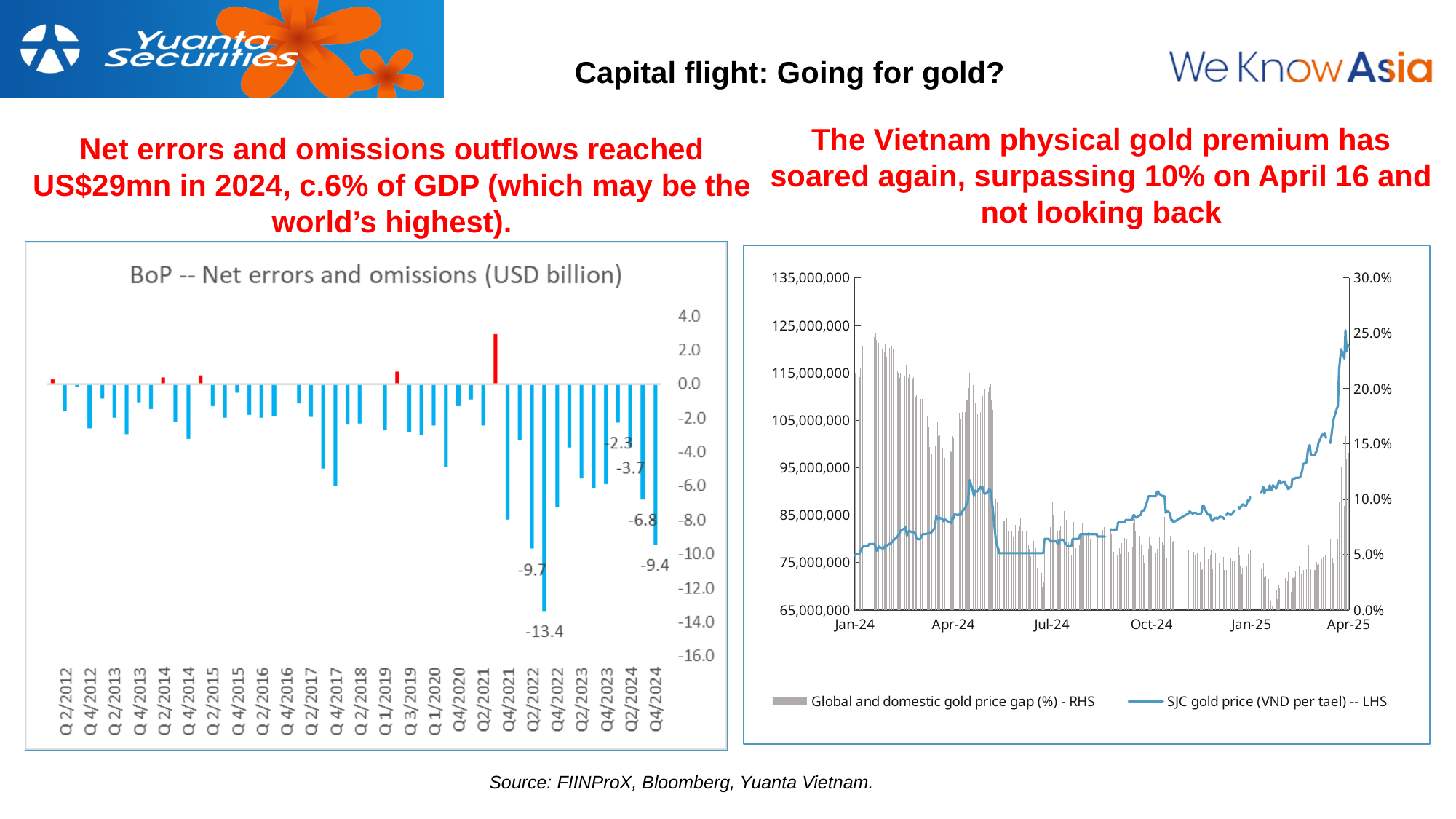
What is the title of the chart on the left? BoP -- Net errors and omissions (USD billion) In the right chart, is the SJC gold price at the end of the series (Apr-25) greater or less than 115,000,000? greater In the left chart, BoP -- Net errors and omissions, what is the lowest labelled value? -13.4 What type of chart is the left chart, BoP -- Net errors and omissions? bar chart In the left chart, BoP -- Net errors and omissions, which is larger: the bar labelled -6.8 or the bar labelled -9.4? -6.8 In the left chart, BoP -- Net errors and omissions, what is the value labelled on the last bar (Q4/2024)? -9.4 In the left chart, BoP -- Net errors and omissions, is the lowest bar greater or less than -12.0? less In the right chart, which series is plotted as a line? SJC gold price (VND per tael) -- LHS In the left chart, BoP -- Net errors and omissions, what is the difference between the labelled values -13.4 and -9.7? 3.7 In the right chart, does the SJC gold price line rise or fall overall from Jan-24 to Apr-25? rise In the left chart, BoP -- Net errors and omissions, how many bars carry a printed data label? 6 In the right chart, how many series does the legend list? 2